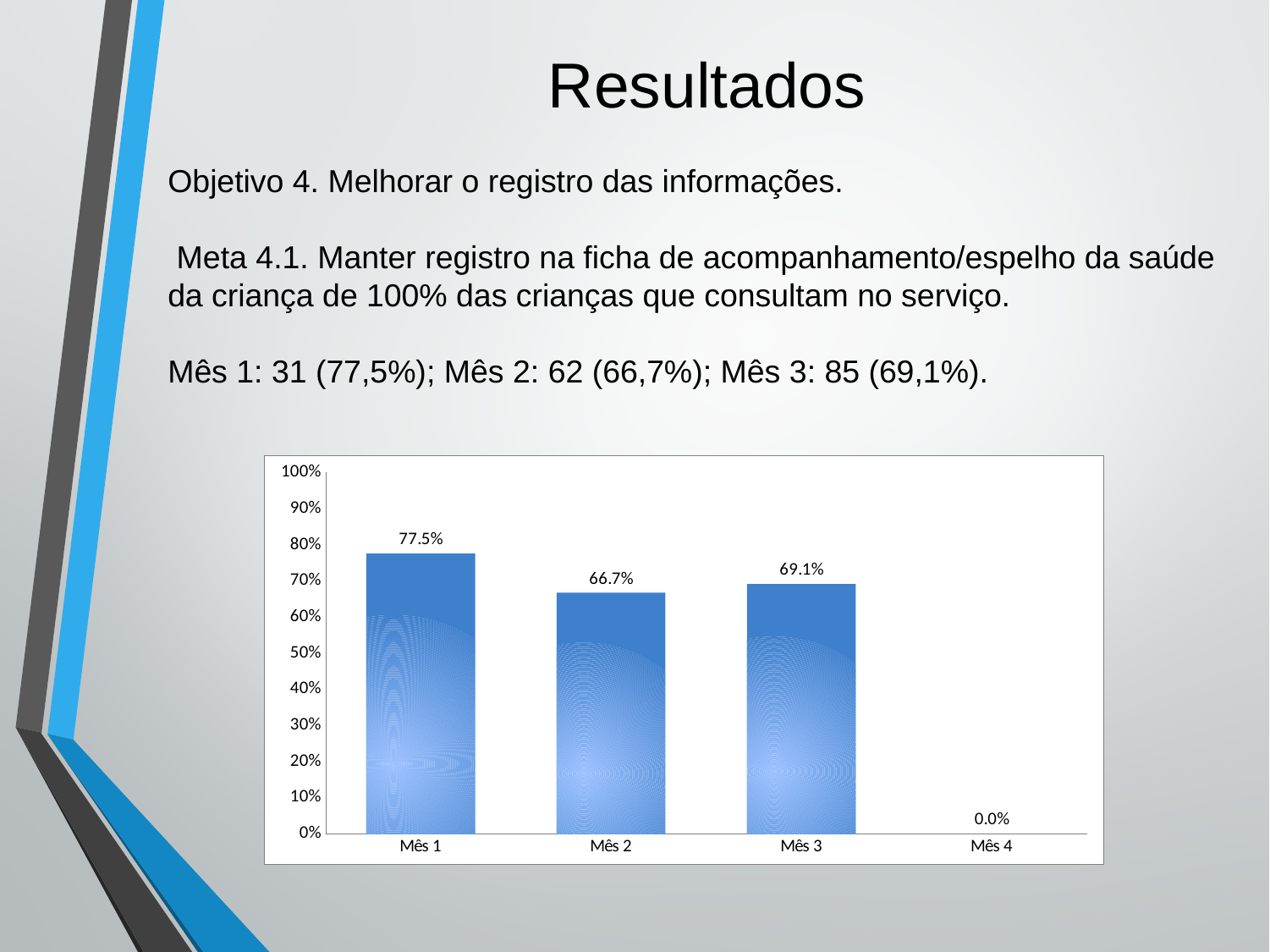
What is the value for Mês 3 in the chart? 69.1% What is the value for Mês 2 in the chart? 66.7% What is the value for Mês 4 in the chart? 0.0% Which month has the lowest value in the chart? Mês 4 What is the value for Mês 1 in the chart? 77.5% Which is larger, the value for Mês 2 or the value for Mês 3? Mês 3 Which month has the highest value in the chart? Mês 1 What is the difference between the values for Mês 3 and Mês 2? 2.4% What kind of chart is shown on the slide? Bar chart What is the difference between the values for Mês 1 and Mês 2? 10.8% Is the value for Mês 1 greater or less than 70%? greater How many categories are shown on the x axis of the chart? 4